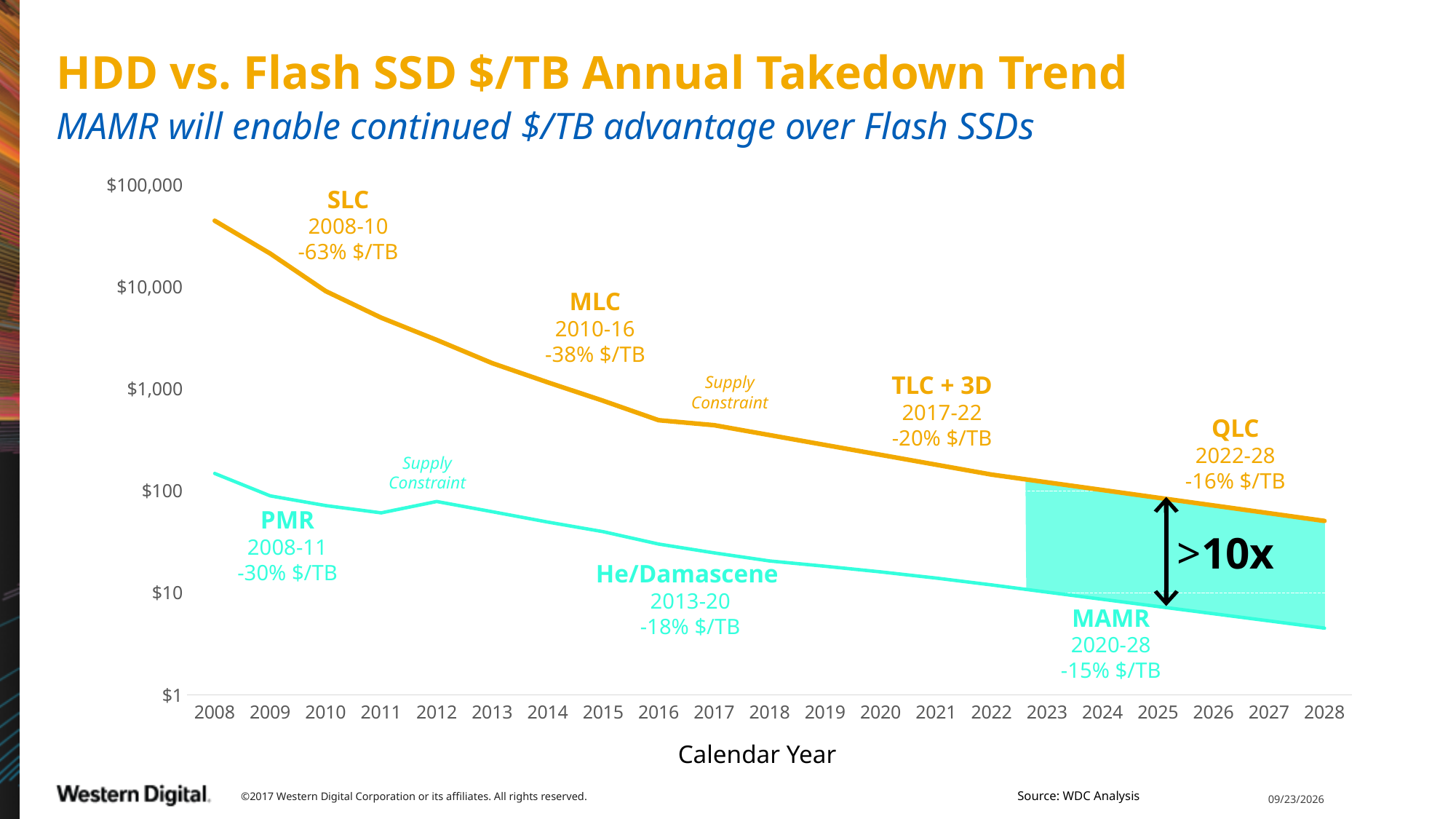
What annual $/TB takedown is shown for MLC? -38% $/TB How many calendar years are labelled on the x axis? 21 What annual $/TB takedown is shown for the SLC period (2008-10)? -63% $/TB Which years does the QLC period cover? 2022-28 Is the value of the orange (Flash SSD) line in 2008 greater or less than $10,000? greater What annual $/TB takedown is shown for He/Damascene (2013-20)? -18% $/TB What is the label of the x axis? Calendar Year What annual $/TB takedown is shown for MAMR? -15% $/TB What is the title of the chart on the slide? HDD vs. Flash SSD $/TB Annual Takedown Trend What kind of chart is shown on the slide? Line chart Do the values of the orange (Flash SSD) line rise or fall from 2008 to 2028? Fall Is the value of the cyan (HDD) line in 2028 greater or less than $10? less